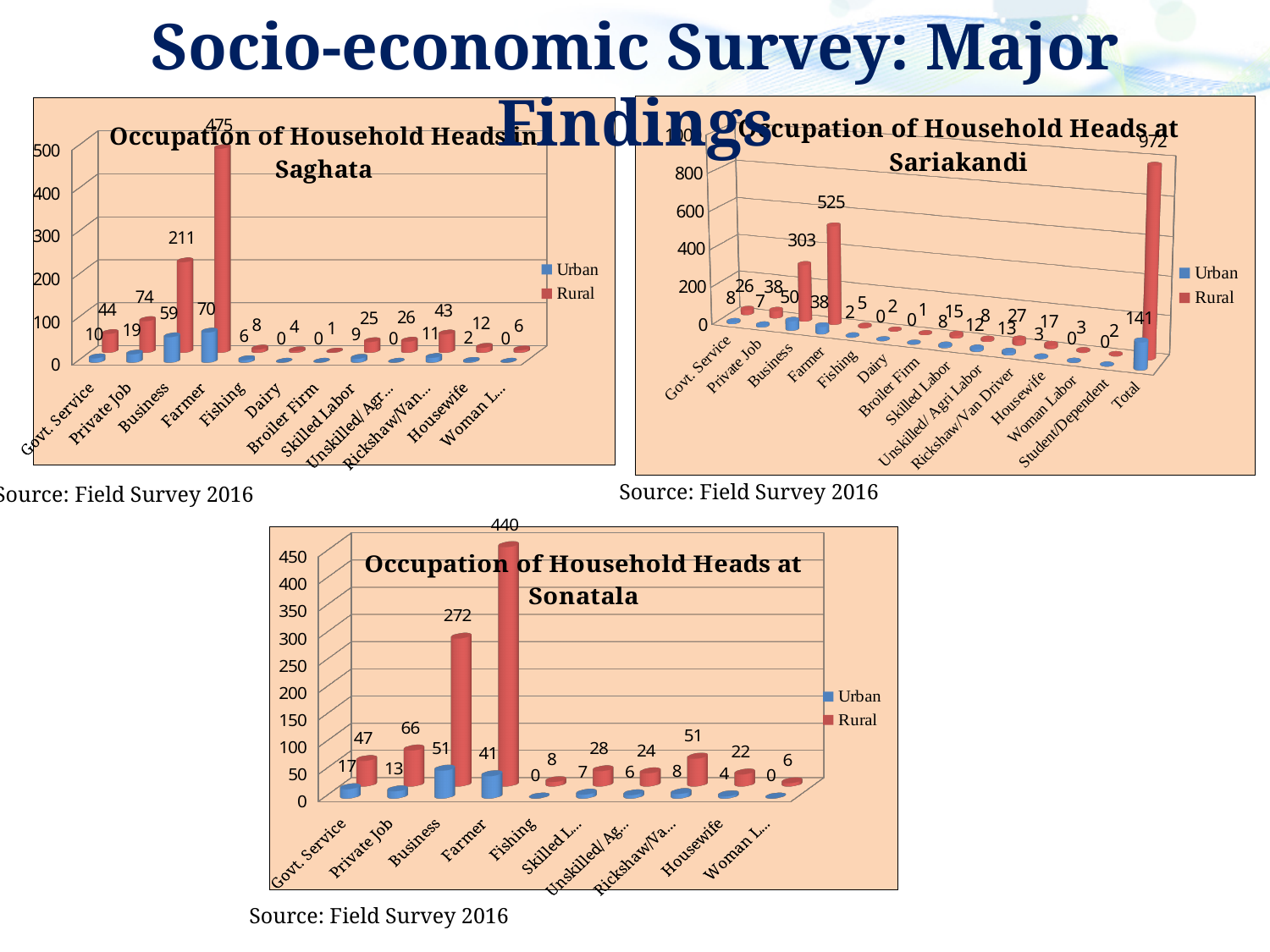
In the 'Occupation of Household Heads at Sonatala' chart, what is the Rural value for Business? 272 In the 'Occupation of Household Heads in Saghata' chart, what is the Rural value for Farmer? 475 In the 'Occupation of Household Heads at Sonatala' chart, what is the difference between the Rural values for Farmer and Business? 168 In the 'Occupation of Household Heads at Sonatala' chart, how many occupation categories are shown on the x axis? 10 In the 'Occupation of Household Heads in Saghata' chart, what is the difference between the Rural and Urban values for Business? 152 What type of chart is the 'Occupation of Household Heads at Sonatala' chart? Bar chart In the 'Occupation of Household Heads at Sariakandi' chart, what is the Urban value for Rickshaw/Van Driver? 13 In the 'Occupation of Household Heads at Sariakandi' chart, what is the Rural value for Total? 972 In the 'Occupation of Household Heads in Saghata' chart, what is the Urban value for Business? 59 In the 'Occupation of Household Heads at Sariakandi' chart, which is larger for Unskilled/Agri Labor, the Urban value or the Rural value? Urban In the 'Occupation of Household Heads at Sariakandi' chart, how many series does the legend list? 2 In the 'Occupation of Household Heads in Saghata' chart, which category has the highest Rural value? Farmer